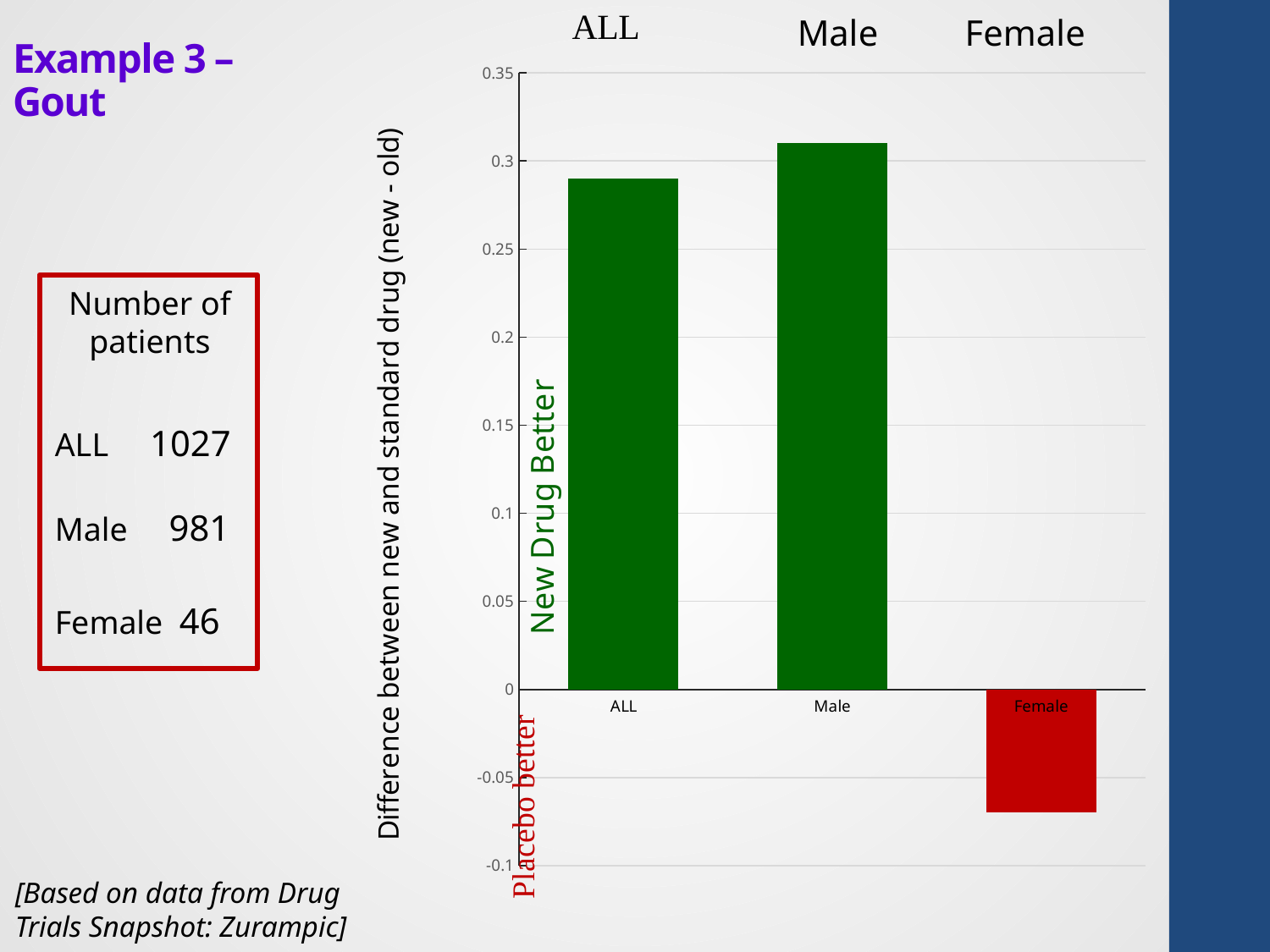
What colour is the bar for Female? red Which is larger, the value for ALL or the value for Female? ALL Which category has the highest value on the chart? Male How many categories are plotted on the chart? 3 What is the label on the vertical axis of the chart? Difference between new and standard drug (new - old) Is the value for Male greater or less than 0.3? greater Which category has the lowest value on the chart? Female Is the value for Female greater or less than -0.05? less Which is larger, the value for Male or the value for ALL? Male What kind of chart is shown on the slide? bar chart Is the value for ALL greater or less than 0.25? greater